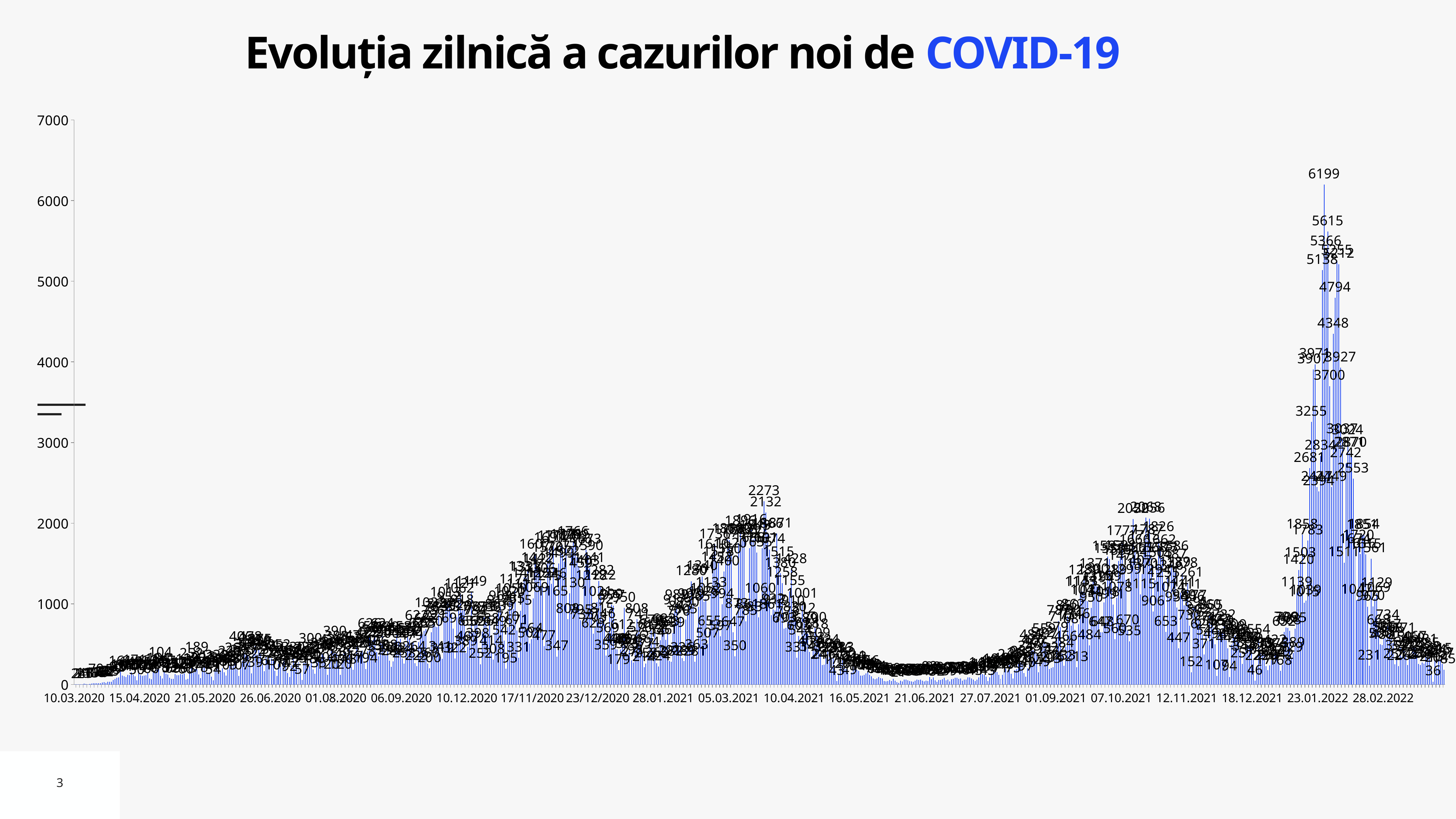
What kind of chart is shown on the slide? bar chart What is the peak value labelled in the wave around March 2021 (near 05.03.2021)? 2273 What is the difference between the highest labelled value (6199) and the second-highest labelled value (5615)? 584 What is the highest value shown on the vertical axis? 7000 Do the daily values rise or fall between 21.06.2021 and 07.10.2021? rise What is the highest daily value labelled on the chart? 6199 What is the first date label on the horizontal axis? 10.03.2020 Are the daily values around 21.06.2021 greater or less than 500? less What is the title of the chart on the slide? Evoluția zilnică a cazurilor noi de COVID-19 What is the last date label on the horizontal axis? 28.02.2022 Which is larger: the peak of the early 2022 wave (6199) or the peak of the March 2021 wave (2273)? the early 2022 wave (6199) Is the highest bar on the chart greater or less than 6000? greater